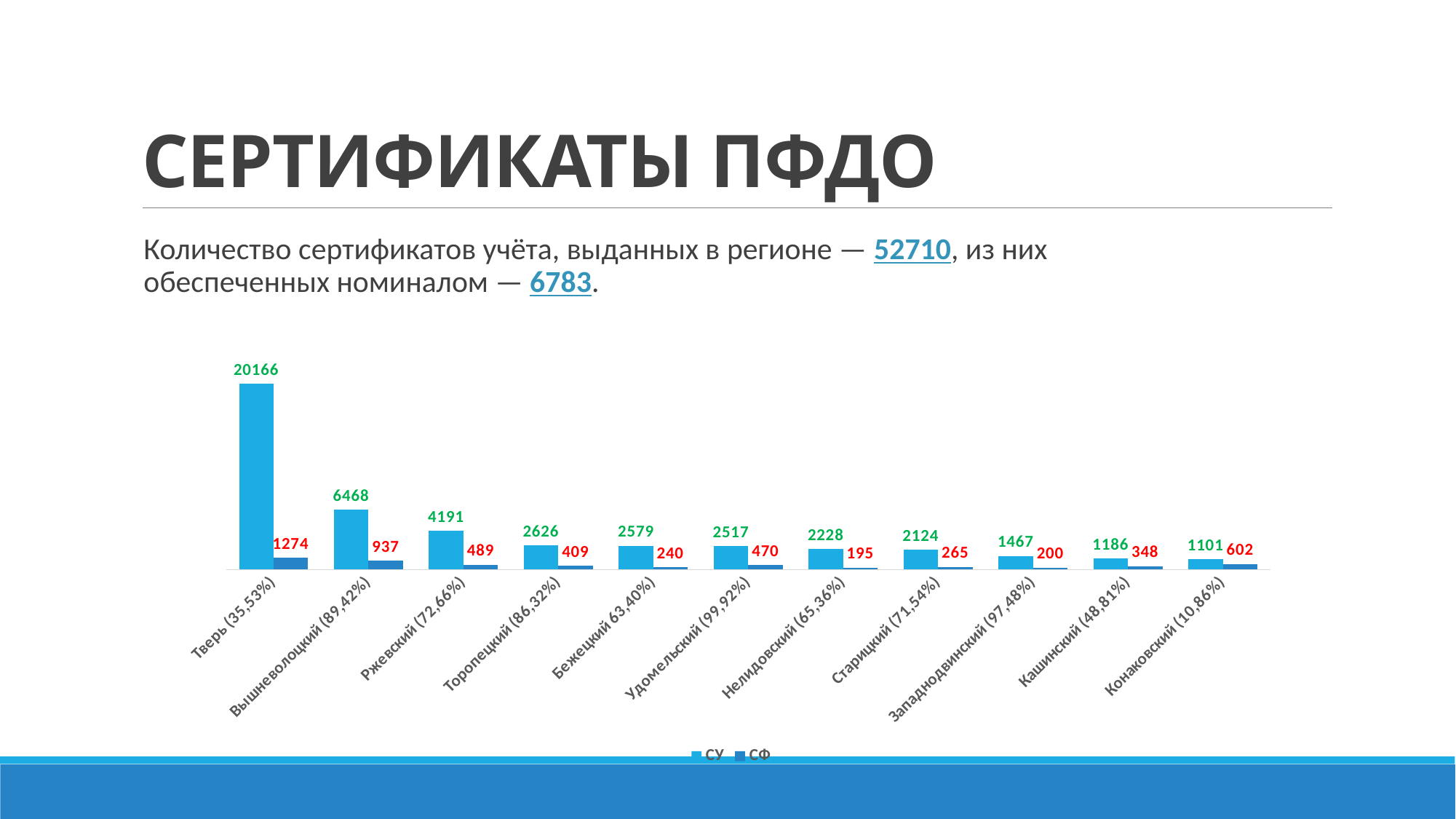
Which has the larger СФ value, Кашинский or Конаковский? Конаковский What is the СУ value for Тверь? 20166 How many categories are shown on the x axis of the chart? 11 What kind of chart is shown on the slide? Bar chart Which category has the lowest СФ value? Нелидовский What is the difference between the СУ and СФ values for Вышневолоцкий? 5531 What is the СФ value for Ржевский? 489 How many series does the legend list? 2 What is the difference between the СУ and СФ values for Тверь? 18892 Which category has the highest СУ value? Тверь What is the СУ value for Удомельский? 2517 Which category has the lowest СУ value? Конаковский